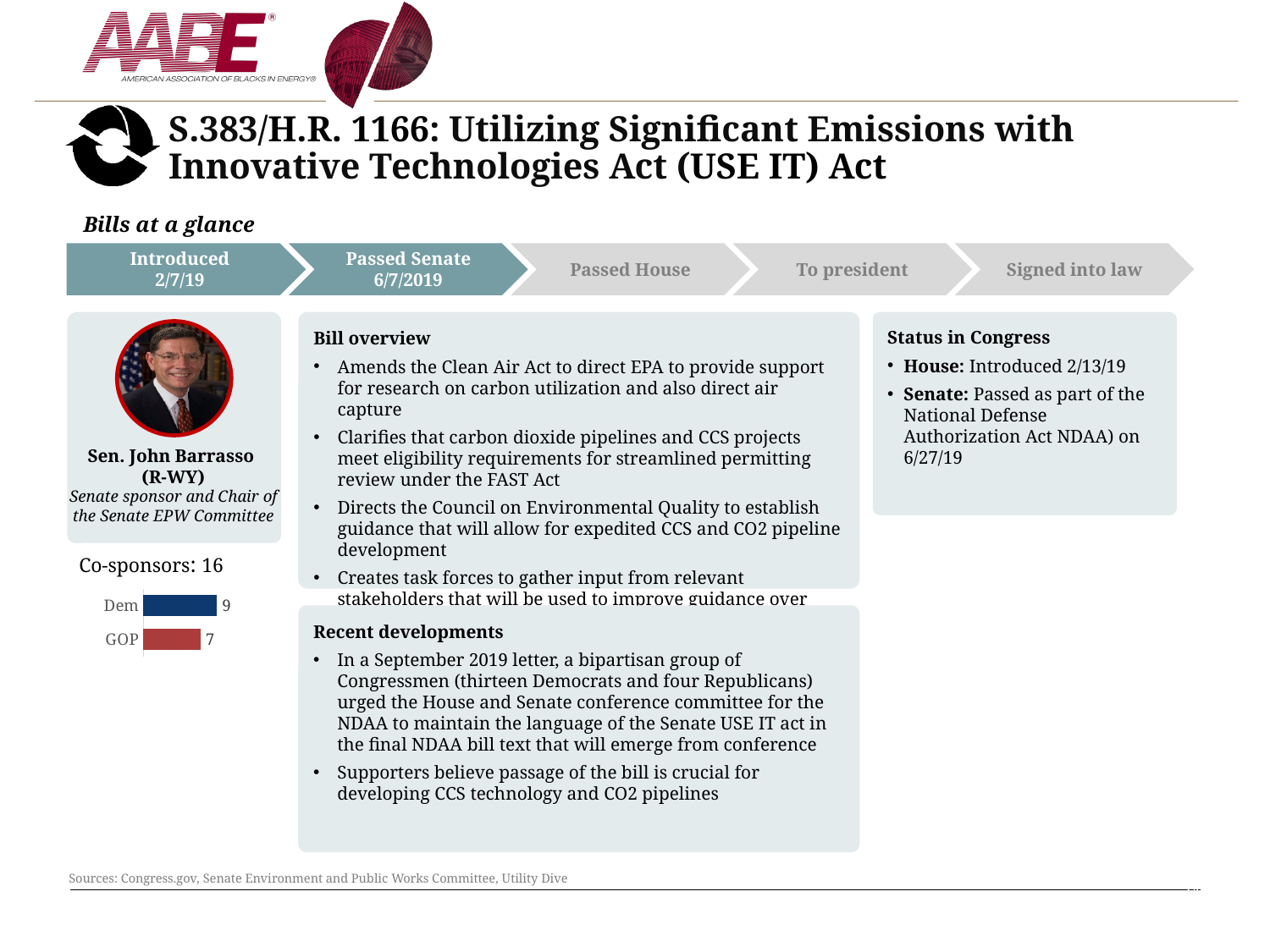
Which is larger in the co-sponsors chart, Dem or GOP? Dem What colour is the Dem bar in the co-sponsors chart? Blue What is the difference between the Dem and GOP values in the co-sponsors chart? 2 What is the value for Dem in the co-sponsors chart? 9 What is the total of the Dem and GOP values in the co-sponsors chart? 16 What is the value for GOP in the co-sponsors chart? 7 Which category has the lowest value in the co-sponsors chart? GOP What colour is the GOP bar in the co-sponsors chart? Red What kind of chart is the co-sponsors chart? Bar chart Which category has the highest value in the co-sponsors chart? Dem How many categories are shown in the co-sponsors chart? 2